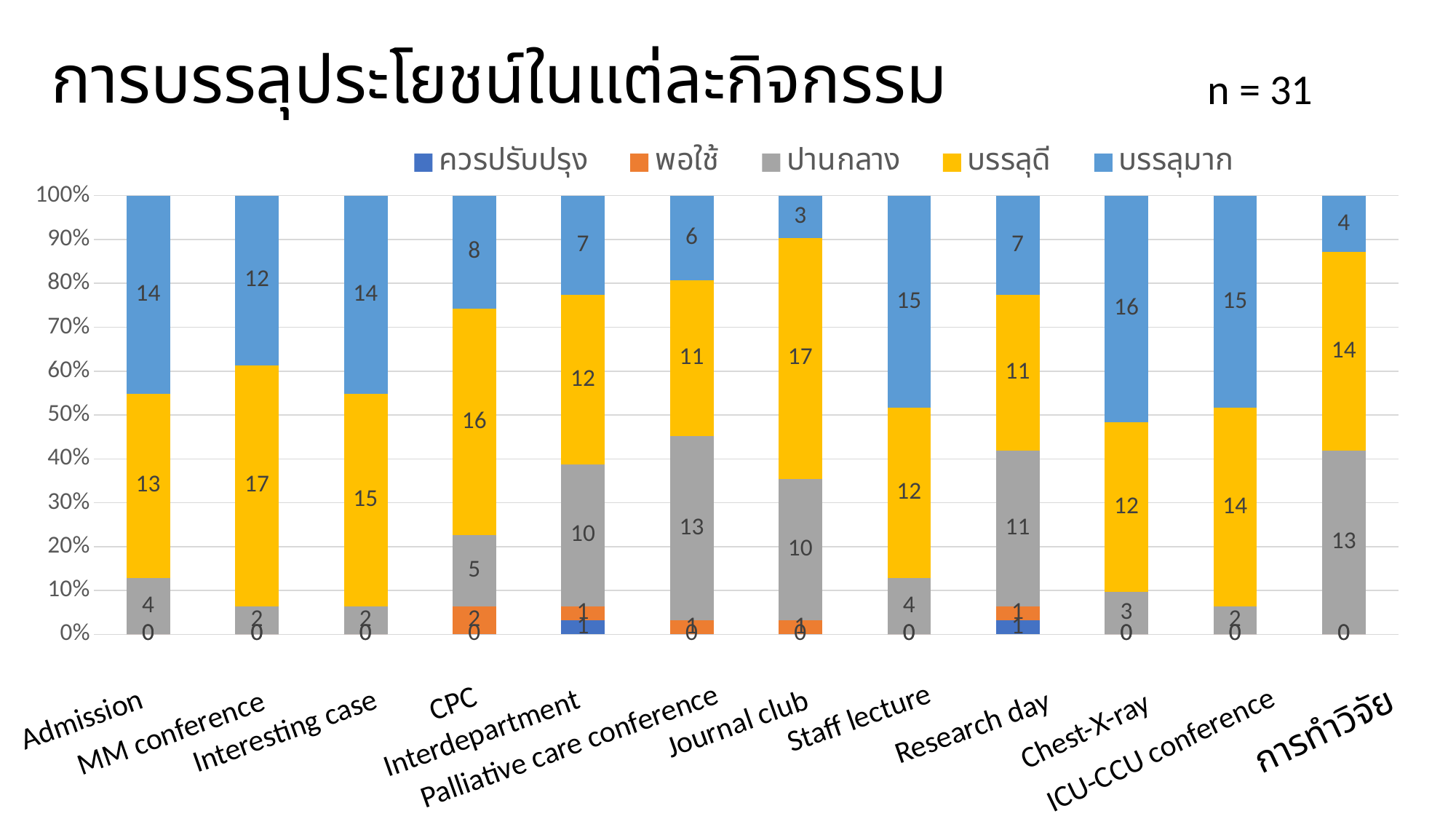
What is the value of ปานกลาง for Palliative care conference? 13 Which category has the lowest value for บรรลุมาก? Journal club What is the value of บรรลุดี for Journal club? 17 What sample size is stated on the slide? n = 31 What is the value of พอใช้ for CPC? 2 How many categories are shown on the x axis? 12 Which category has the highest value for บรรลุมาก? Chest-X-ray How many series does the legend list? 5 What kind of chart is shown on the slide? Stacked bar chart What is the value of บรรลุมาก for Admission? 14 Which is larger: the ปานกลาง value for Interdepartment or for Staff lecture? Interdepartment What is the difference between the บรรลุดี values for MM conference and Admission? 4